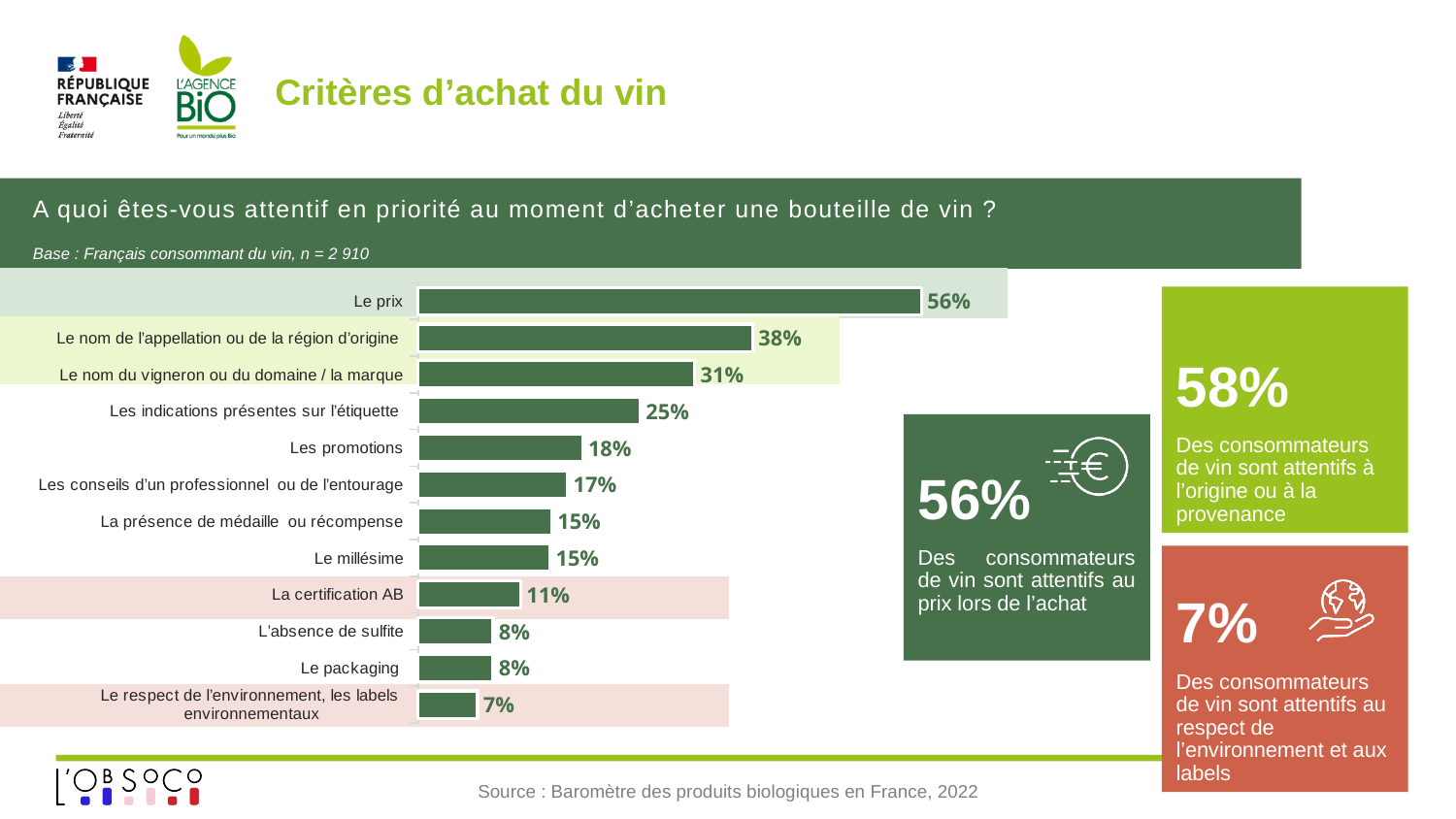
Which criterion has the highest value in the chart? Le prix How many criteria (categories) are shown in the bar chart? 12 Which criterion has the lowest value in the chart? Le respect de l'environnement, les labels environnementaux What is the value shown for 'La certification AB'? 11% Which has a higher value: 'Le nom du vigneron ou du domaine / la marque' or 'Les indications présentes sur l'étiquette'? Le nom du vigneron ou du domaine / la marque What is the value shown for 'Le millésime'? 15% What is the difference in percentage points between 'Le prix' and 'Le nom de l'appellation ou de la région d'origine'? 18 percentage points What is the value shown for 'Les indications présentes sur l'étiquette'? 25% What type of chart is used on this slide? Bar chart Which has a higher value: 'Les promotions' or 'Les conseils d'un professionnel ou de l'entourage'? Les promotions Do the values in the chart increase or decrease from the top bar to the bottom bar? Decrease What percentage of wine consumers say they pay attention to 'Le prix' when buying a bottle of wine? 56%